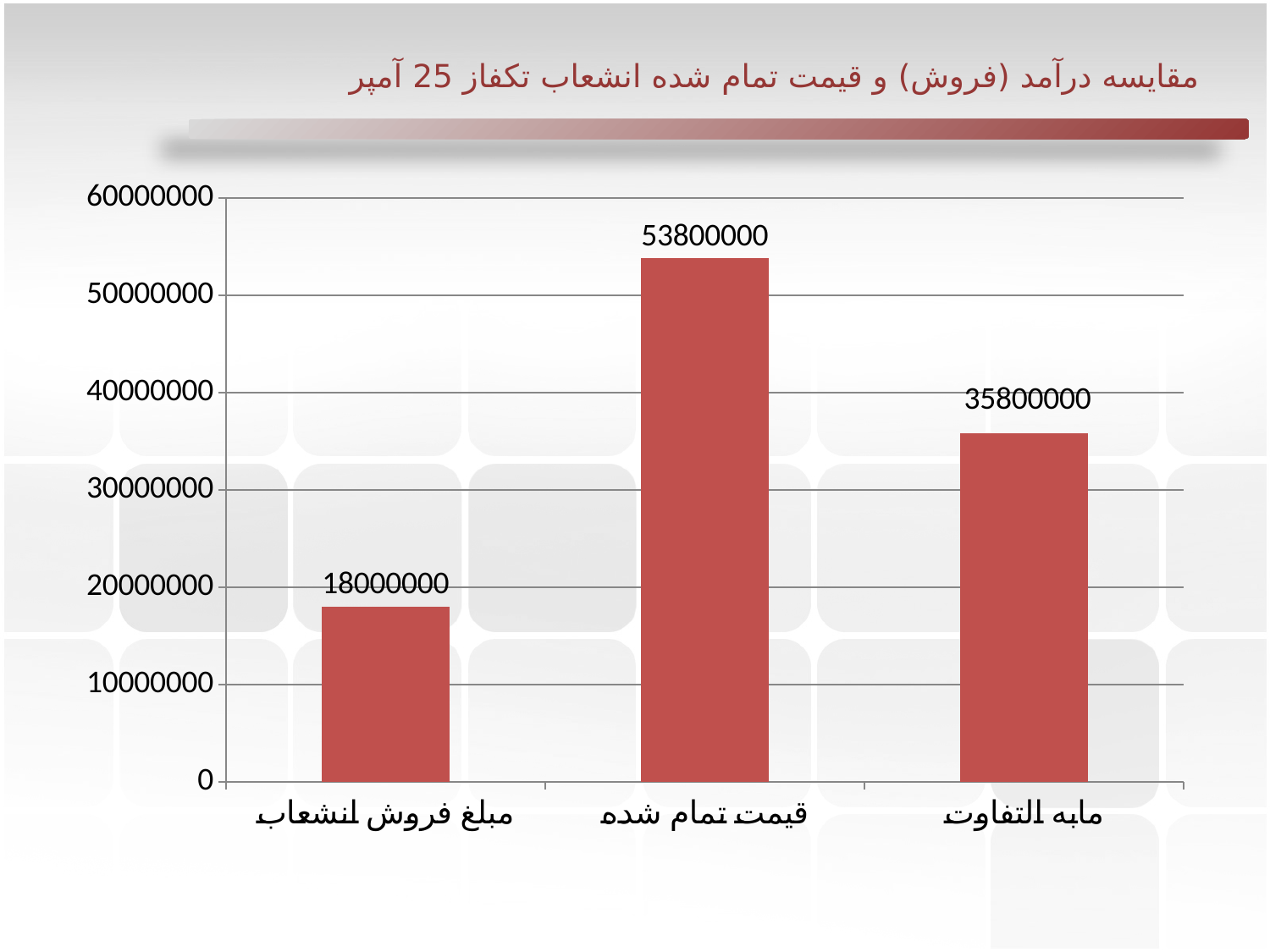
How many categories are shown in the chart? 3 What is the value for مابه التفاوت? 35800000 Which category has the lowest value? مبلغ فروش انشعاب What is the title of the slide? مقایسه درآمد (فروش) و قیمت تمام شده انشعاب تکفاز 25 آمپر What kind of chart is shown on the slide? bar chart Which category has the highest value? قیمت تمام شده What is the difference between قیمت تمام شده and مابه التفاوت? 18000000 What is the value for مبلغ فروش انشعاب? 18000000 What is the difference between قیمت تمام شده and مبلغ فروش انشعاب? 35800000 Is the value for مابه التفاوت greater or less than 30000000? greater Which is larger, مابه التفاوت or مبلغ فروش انشعاب? مابه التفاوت What is the value for قیمت تمام شده? 53800000